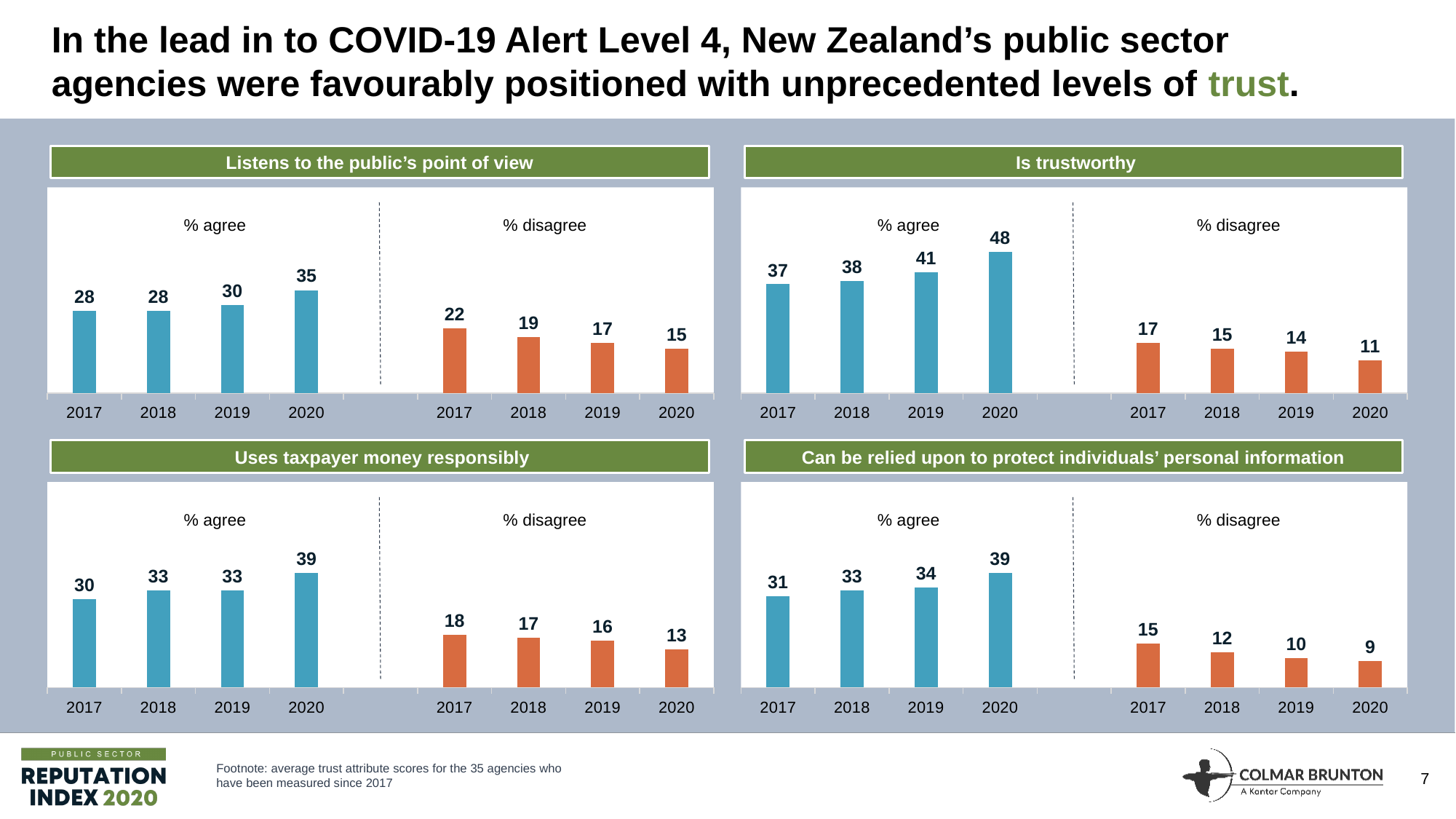
In the 'Listens to the public's point of view' chart, what is the % disagree value for 2017? 22 In the 'Is trustworthy' chart, what is the difference between the % disagree values for 2017 and 2020? 6 In the 'Listens to the public's point of view' chart, what is the difference between the % agree values for 2020 and 2017? 7 In the 'Is trustworthy' chart, do the % agree values rise or fall from 2017 to 2020? rise In the 'Can be relied upon to protect individuals' personal information' chart, how many years are shown in the % agree section? 4 In the 'Can be relied upon to protect individuals' personal information' chart, which year has the lowest % disagree value? 2020 In the 'Uses taxpayer money responsibly' chart, what is the % agree value for 2018? 33 In the 'Can be relied upon to protect individuals' personal information' chart, what is the % disagree value for 2020? 9 What type of chart is used in the 'Uses taxpayer money responsibly' panel? bar chart In the 'Is trustworthy' chart, what is the % agree value for 2020? 48 In the 'Is trustworthy' chart, which year has the highest % agree value? 2020 In the 'Uses taxpayer money responsibly' chart, which is larger: the % agree value for 2020 or the % disagree value for 2017? % agree for 2020